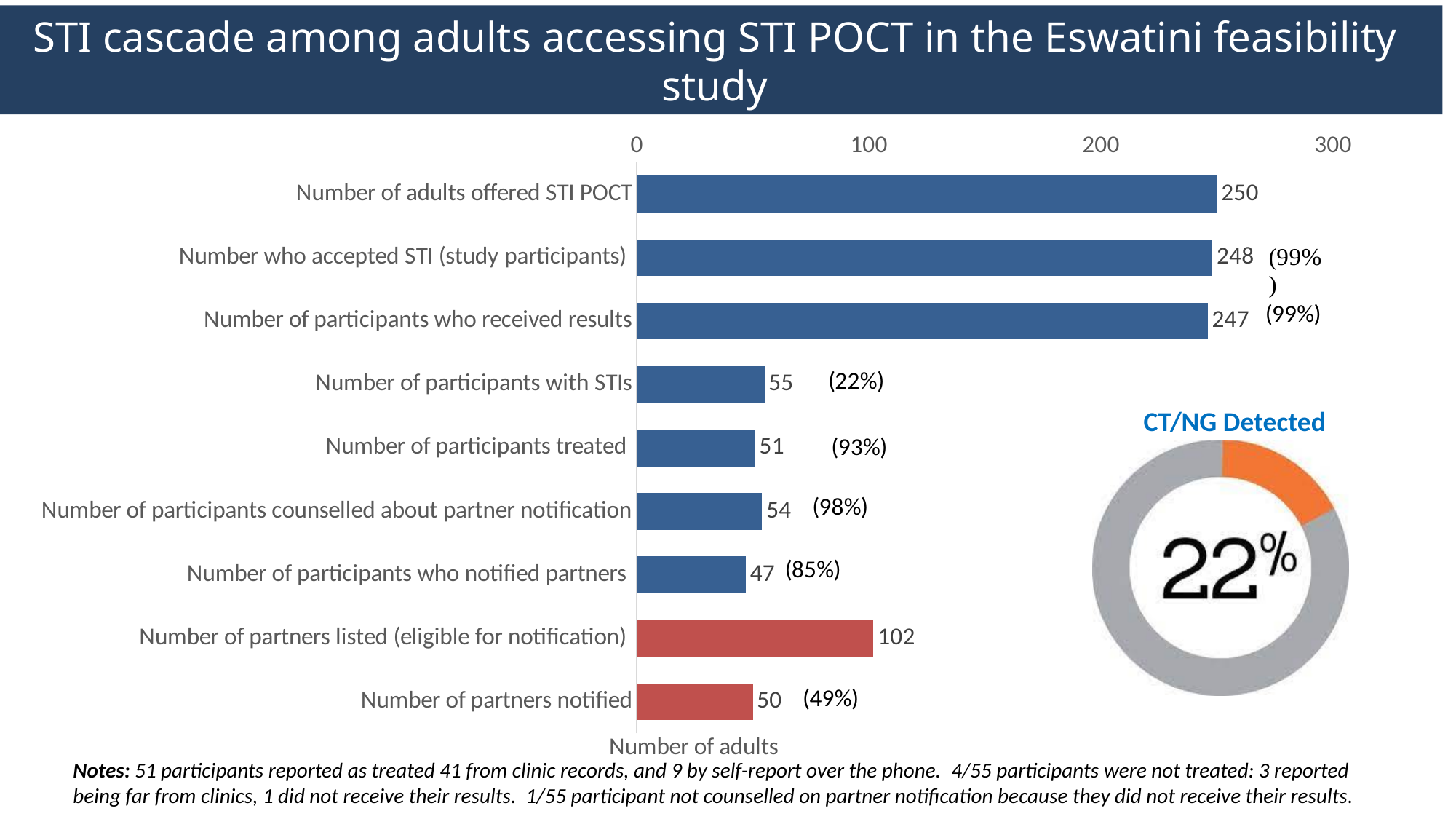
In the bar chart, which category has the highest value? Number of adults offered STI POCT How many categories does the bar chart show? 9 In the bar chart, what is the value for 'Number of adults offered STI POCT'? 250 In the bar chart, which category has the lowest value? Number of participants who notified partners In the bar chart, what is the difference between 'Number of participants with STIs' and 'Number of participants treated'? 4 In the 'CT/NG Detected' donut chart, what percentage is shown? 22% What kind of chart is the chart on the left of the slide? bar chart In the bar chart, is the value for 'Number of participants who received results' greater or less than 200? greater What is the x-axis title of the bar chart? Number of adults In the bar chart, which is larger: 'Number of partners listed (eligible for notification)' or 'Number of partners notified'? Number of partners listed (eligible for notification) In the bar chart, what is the value for 'Number of participants who notified partners'? 47 In the bar chart, what is the value for 'Number of partners listed (eligible for notification)'? 102